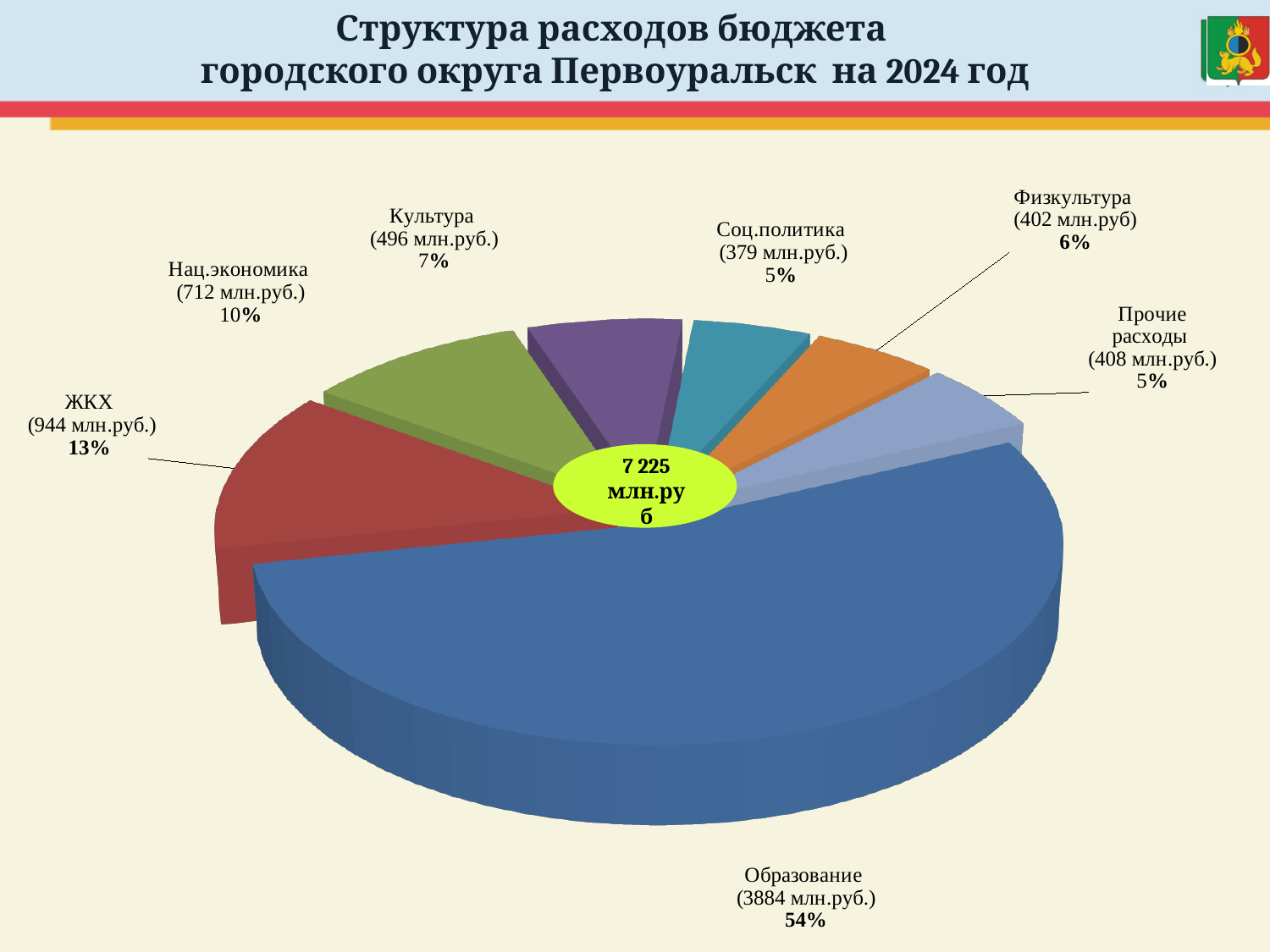
What share of the pie does Культура represent? 7% Which is larger, the value for Физкультура or the value for Соц.политика? Физкультура What type of chart is shown on the slide? pie chart What is the title of the chart on the slide? Структура расходов бюджета городского округа Первоуральск на 2024 год What share of the pie does ЖКХ represent? 13% How many slices does the pie chart have? 7 What is the difference between the values for ЖКХ and Нац.экономика? 232 млн.руб. What total amount is shown in the centre of the pie chart? 7 225 млн.руб What is the value for Образование? 3884 млн.руб. Which category has the largest slice? Образование Which category has the smallest value? Соц.политика What is the value for Нац.экономика? 712 млн.руб.